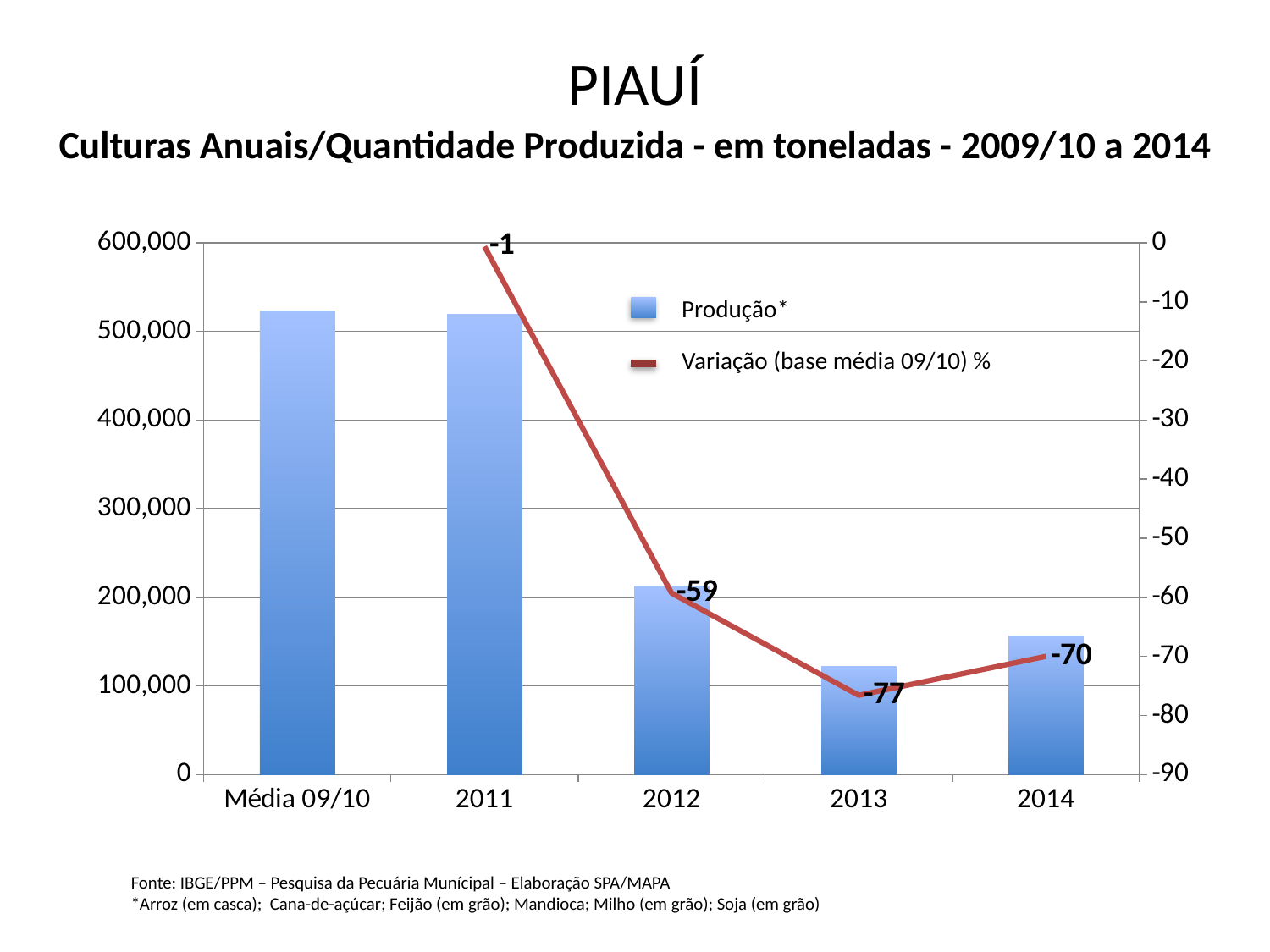
What is the difference between the Variação values for 2012 and 2013? 18 Is the Produção bar for Média 09/10 greater or less than 500,000? greater What is the value of the Variação (base média 09/10) % line for 2014? -70 What is the value of the Variação (base média 09/10) % line for 2012? -59 What is the value of the Variação (base média 09/10) % line for 2011? -1 How many categories are shown on the x axis? 5 In which year does the Variação (base média 09/10) % line reach its lowest value? 2013 Which has a larger Produção bar, 2013 or 2014? 2014 Is the Produção bar for 2012 greater or less than 300,000? less What is the value of the Variação (base média 09/10) % line for 2013? -77 What kinds of chart are combined on this slide? A bar chart and a line chart How many series does the legend list? 2